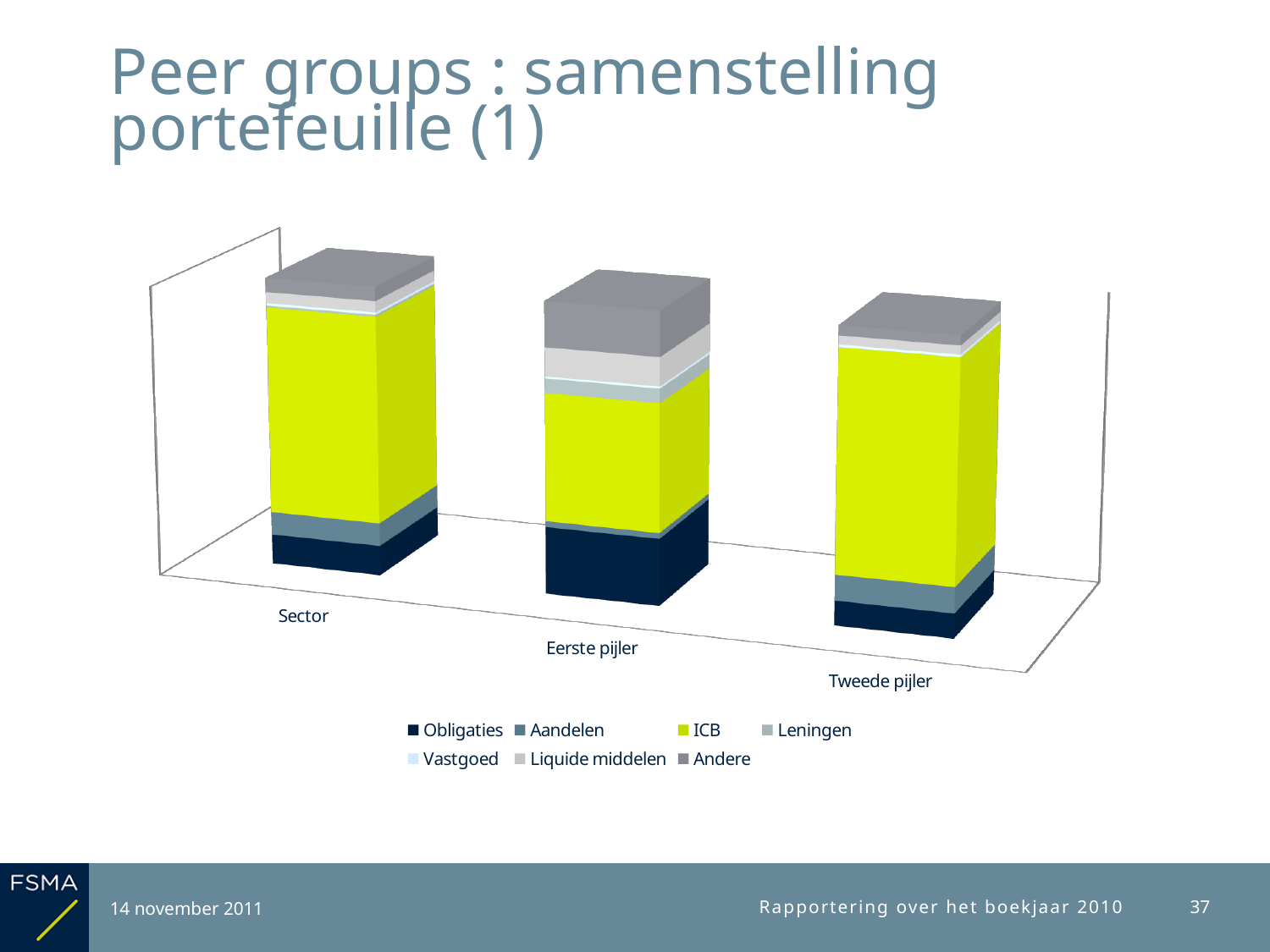
How many categories are shown along the horizontal axis of the chart? 3 Is the Obligaties segment larger for Eerste pijler or for Tweede pijler? Eerste pijler Which series forms the largest segment of the Sector bar? ICB What is the label of the middle category on the chart's horizontal axis? Eerste pijler Which series is shown in yellow-green in the chart's legend? ICB What kind of chart is shown on the slide? Stacked bar chart Which series forms the largest segment of the Tweede pijler bar? ICB How many series does the chart's legend list? 7 What is the title of the slide containing the chart? Peer groups : samenstelling portefeuille (1) Is the Liquide middelen segment larger for Eerste pijler or for Sector? Eerste pijler Is the ICB segment larger for Sector or for Eerste pijler? Sector